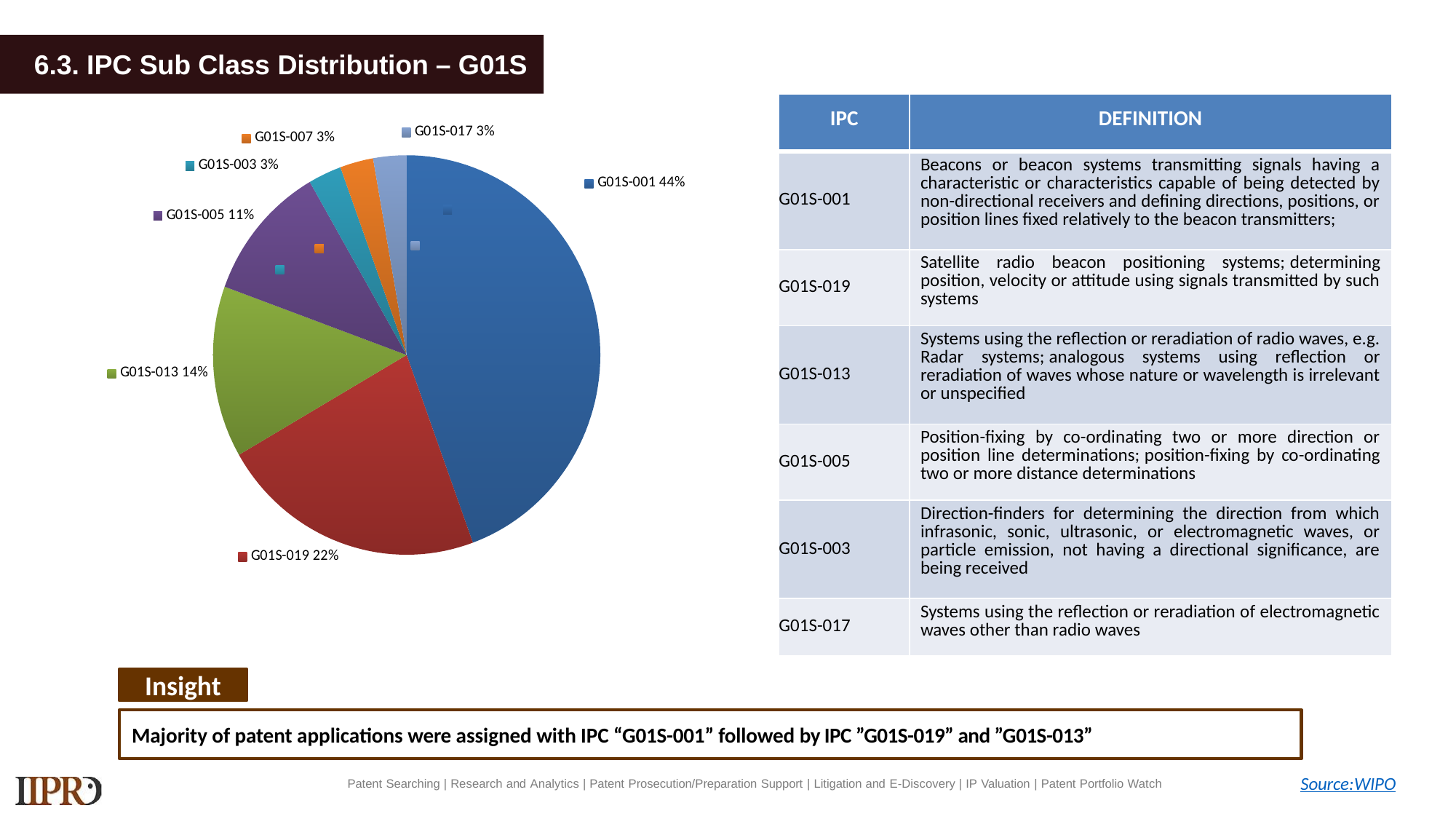
What share of the pie does G01S-013 have? 14% What share of the pie does G01S-001 have? 44% What share of the pie does G01S-019 have? 22% What kind of chart is shown on the slide? pie chart What is the difference in percentage points between G01S-019 and G01S-013? 8 What colour is the slice for G01S-001? blue What is the difference in percentage points between G01S-001 and G01S-019? 22 Which is larger, the share for G01S-013 or the share for G01S-005? G01S-013 How many slices does the pie chart have? 7 Which IPC sub class has the largest slice of the pie? G01S-001